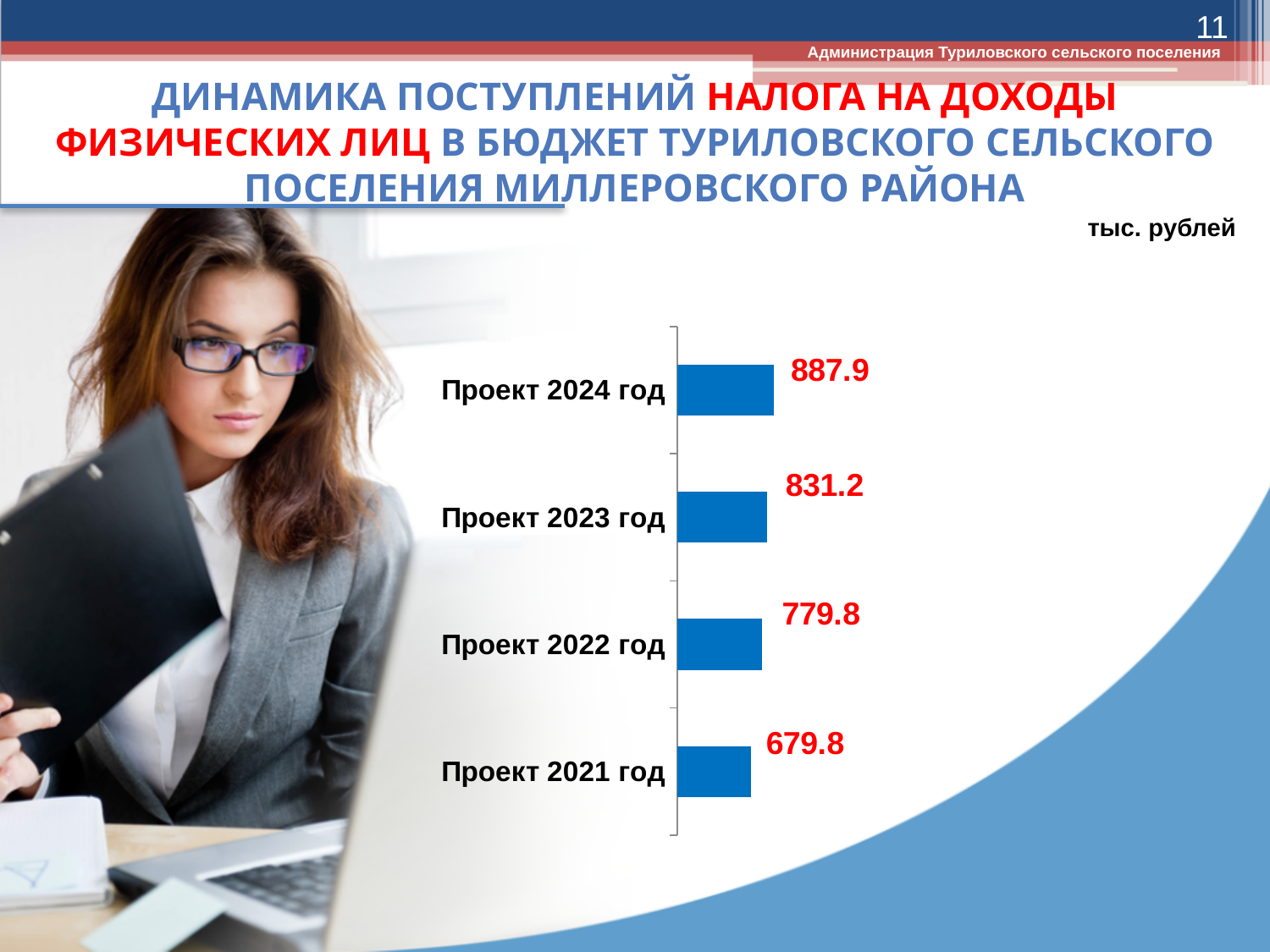
What unit is stated for the chart values? тыс. рублей What is the value for Проект 2024 год? 887.9 What is the value for Проект 2021 год? 679.8 Which category has the lowest value? Проект 2021 год What is the difference between the values for Проект 2024 год and Проект 2023 год? 56.7 Which is larger, the value for Проект 2023 год or Проект 2022 год? Проект 2023 год What is the difference between the values for Проект 2022 год and Проект 2021 год? 100.0 What is the value for Проект 2022 год? 779.8 What kind of chart is shown on the slide? Bar chart What is the value for Проект 2023 год? 831.2 How many categories are shown in the chart? 4 Which category has the highest value? Проект 2024 год